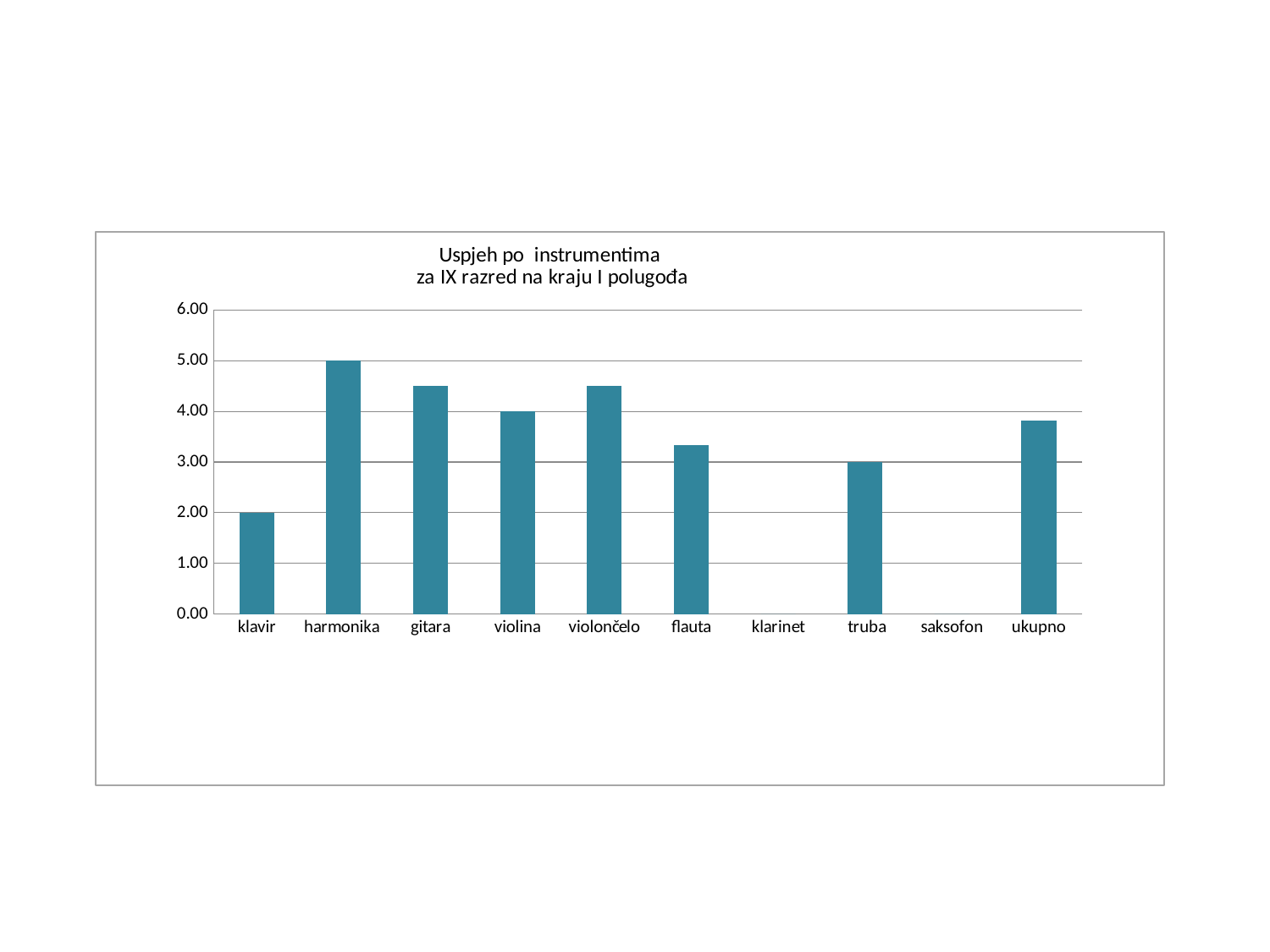
Which instrument has the highest value? harmonika What is the value for violina? 4.00 What is the value for truba? 3.00 What is the value for klavir? 2.00 Is the value for ukupno greater or less than 4.00? less What is the value for harmonika? 5.00 How many categories are shown on the x axis? 10 What is the difference between the values for harmonika and klavir? 3.00 Which is larger, the value for violina or the value for truba? violina Is the value for gitara greater or less than 4.00? greater What type of chart is shown on the slide? bar chart What is the title of the chart? Uspjeh po instrumentima za IX razred na kraju I polugođa